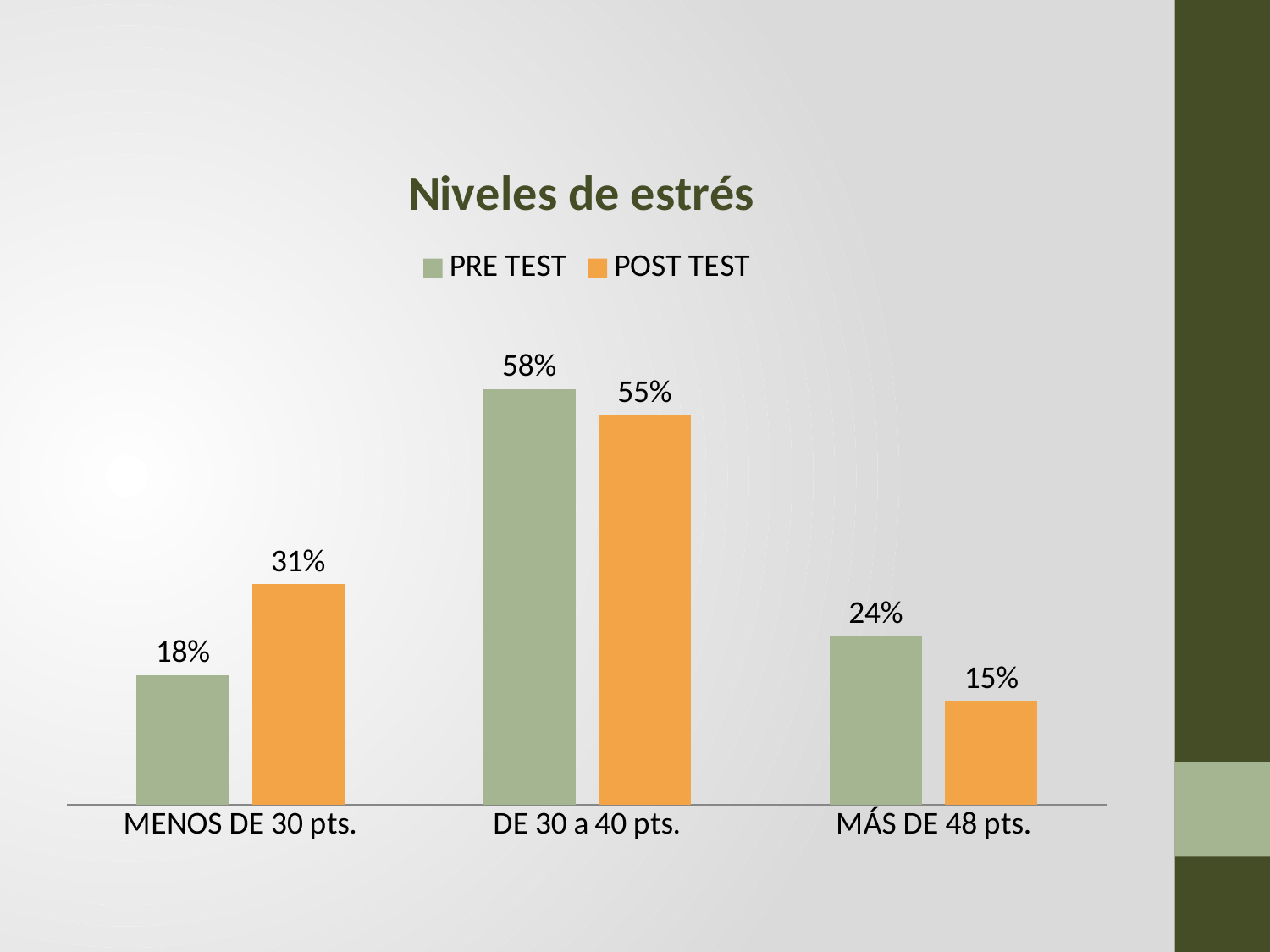
Which category has the lowest POST TEST value? MÁS DE 48 pts. How many categories are shown on the x axis? 3 What is the POST TEST value for MÁS DE 48 pts.? 15% What is the difference between the PRE TEST and POST TEST values for MÁS DE 48 pts.? 9% Which category has the highest PRE TEST value? DE 30 a 40 pts. What kind of chart is shown on the slide? Bar chart Which is larger for DE 30 a 40 pts., the PRE TEST or the POST TEST value? PRE TEST What is the title of the chart? Niveles de estrés What is the difference between the PRE TEST and POST TEST values for MENOS DE 30 pts.? 13% What is the PRE TEST value for MENOS DE 30 pts.? 18% What is the POST TEST value for DE 30 a 40 pts.? 55% How many series does the legend list? 2